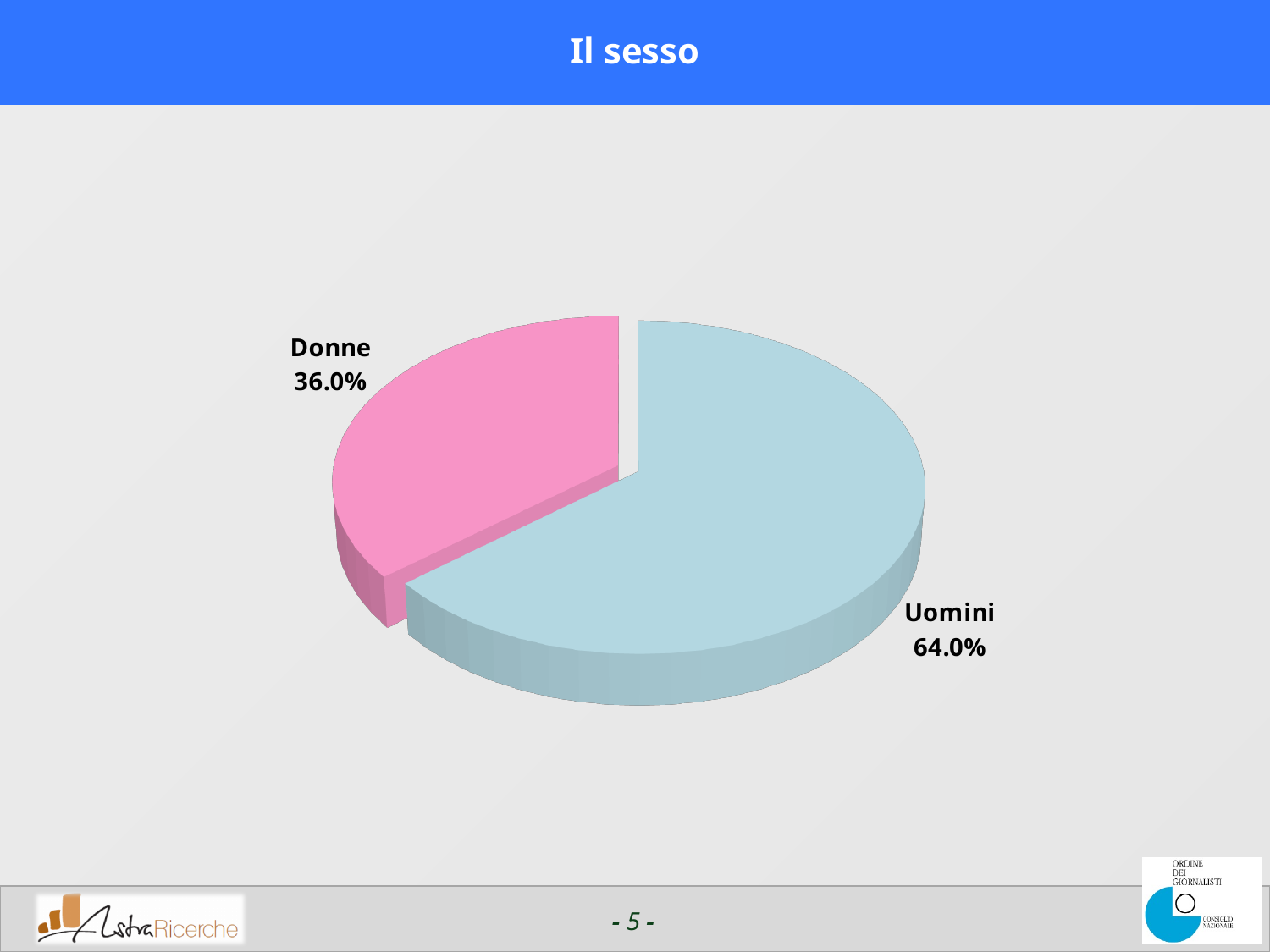
What kind of chart is shown on the slide? Pie chart What is the difference in percentage points between the Uomini and Donne slices? 28.0% What colour is the Donne slice of the pie chart? Pink What percentage of the pie chart is labelled Donne? 36.0% What percentage of the pie chart is labelled Uomini? 64.0% Which slice of the pie chart is the largest? Uomini How many slices does the pie chart have? 2 What is the title of the slide containing the pie chart? Il sesso Is the value for Donne greater or less than 50%? less Which is larger, the Donne slice or the Uomini slice? Uomini Which slice of the pie chart is the smallest? Donne What share of the pie does the Uomini slice represent? 64.0%